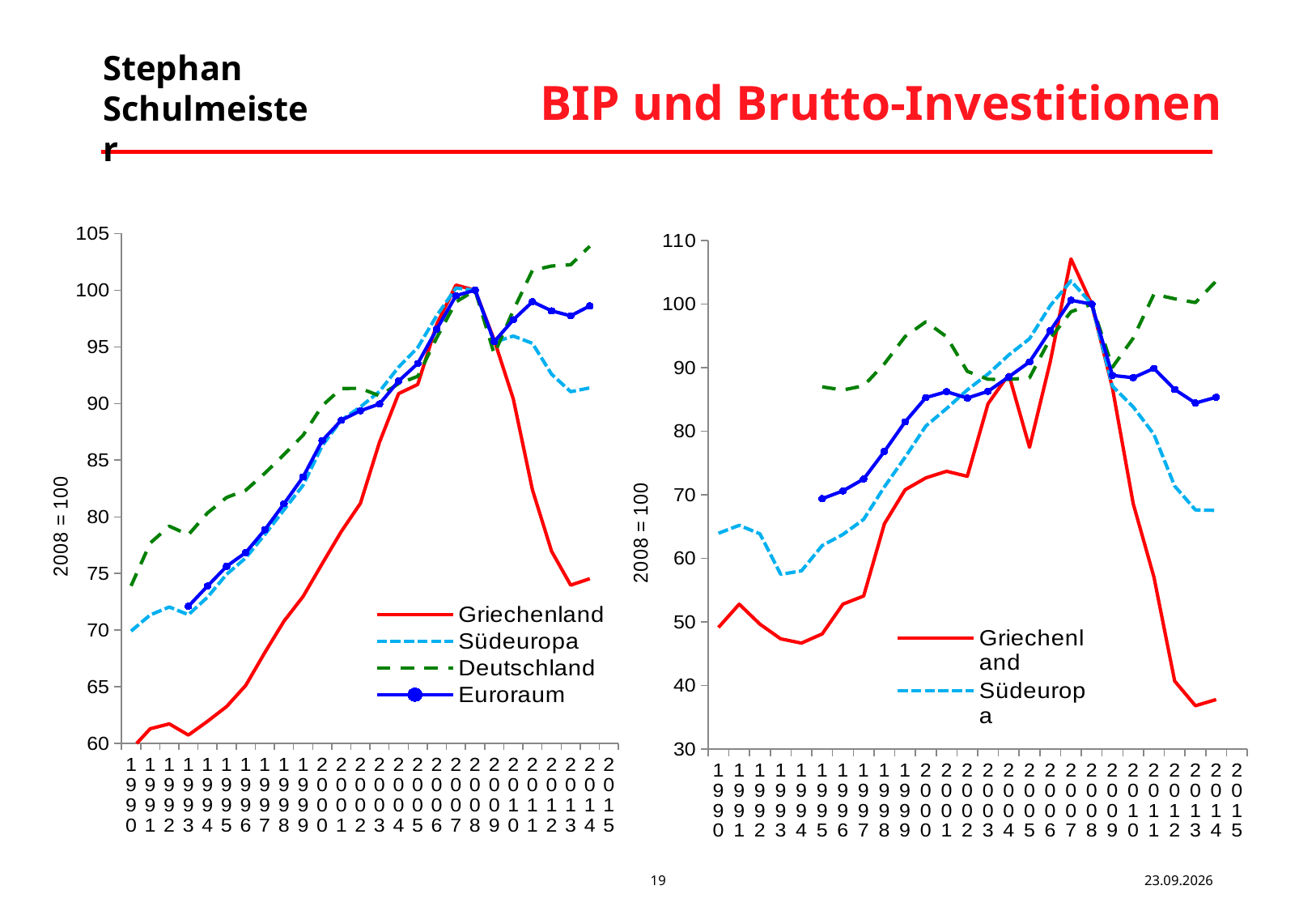
What kind of chart is the left chart on the slide? line chart How many series does the legend of the right chart list? 2 In the right chart, is the value for Südeuropa in 2014 greater or less than 70? less In the left chart, is the value for Euroraum in 2014 greater or less than 100? less How many series does the legend of the left chart list? 4 In the left chart, is the value for Griechenland in 2014 greater or less than 80? less In the left chart, which series has the higher value in 2014, Deutschland or Griechenland? Deutschland What is the label on the vertical axis of the left chart? 2008 = 100 In the right chart, does the Griechenland line rise or fall between 2008 and 2013? fall